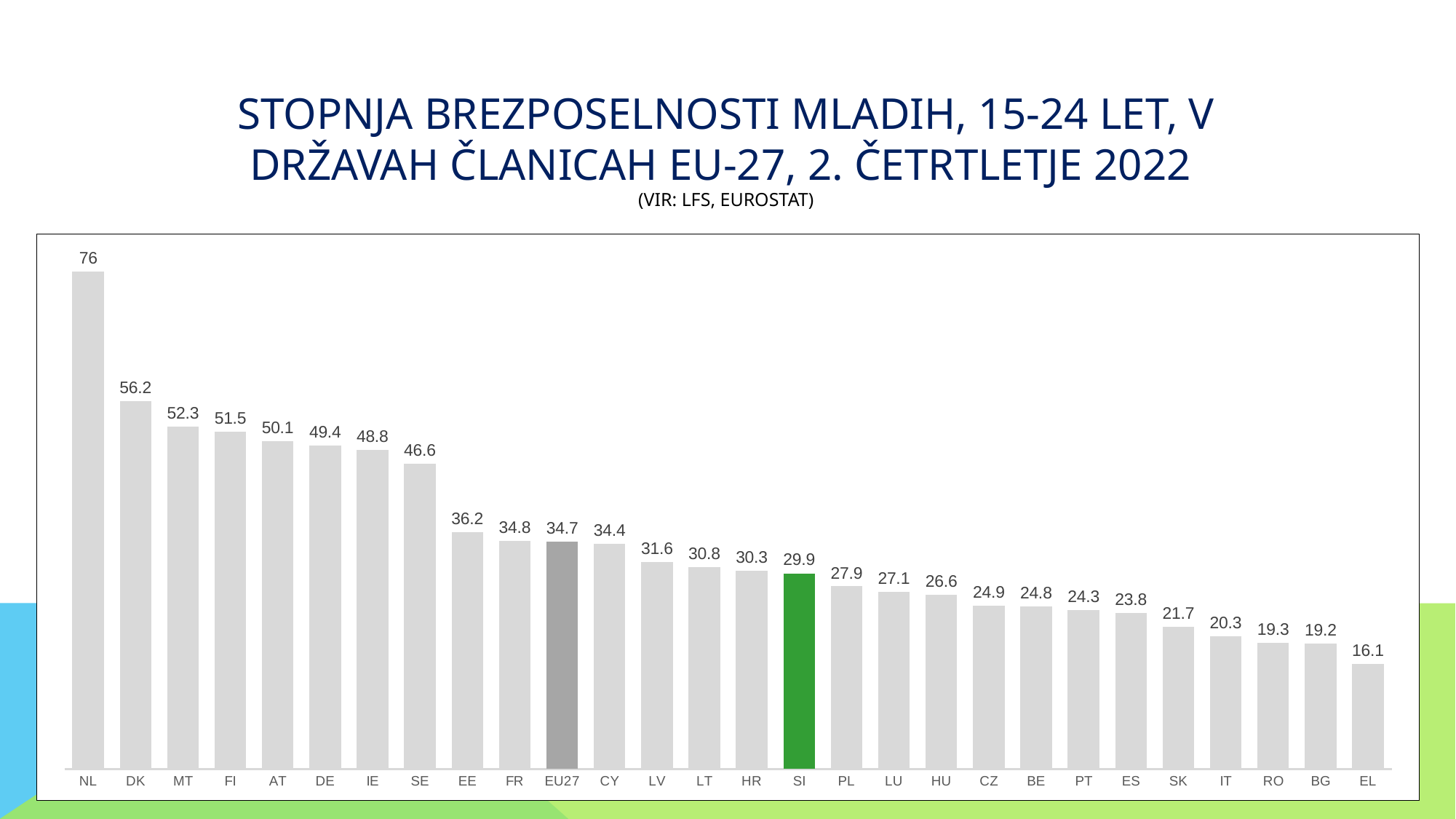
What type of chart is shown on the slide? Bar chart Which bar is coloured green in the chart? SI How much lower is the value for SI than the value for EU27? 4.8 Which country has the lowest value in the chart? EL Which country has the highest value in the chart? NL What is the difference between the values for NL and DK? 19.8 What is the value shown for DE? 49.4 What is the value shown for SI? 29.9 Which has a larger value, FR or CY? FR What is the value shown for EU27? 34.7 Do the values rise or fall from left to right along the x axis? Fall How many bars are shown in the chart? 28